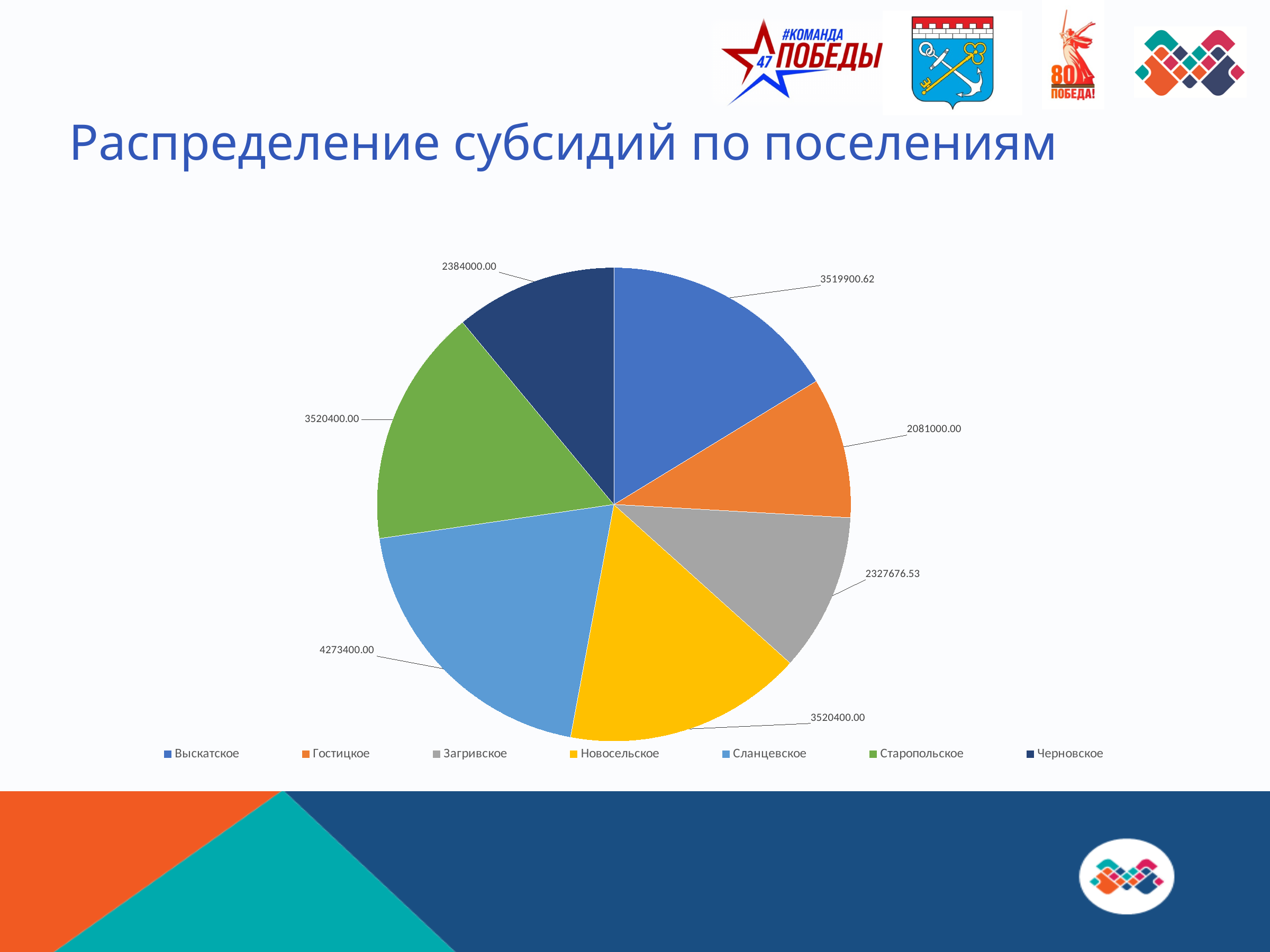
Which is larger, the value for Старопольское or the value for Черновское? Старопольское What is the difference between the values for Сланцевское and Гостицкое? 2192400.00 What is the value for Гостицкое in the pie chart? 2081000.00 What is the value for Выскатское in the pie chart? 3519900.62 Which settlement has the largest slice in the pie chart? Сланцевское What is the value for Сланцевское in the pie chart? 4273400.00 Which settlement has the smallest slice in the pie chart? Гостицкое What is the value for Черновское in the pie chart? 2384000.00 How many categories (settlements) does the pie chart show? 7 What type of chart is shown on the slide? Pie chart What is the value for Загривское in the pie chart? 2327676.53 What is the title of the chart slide? Распределение субсидий по поселениям